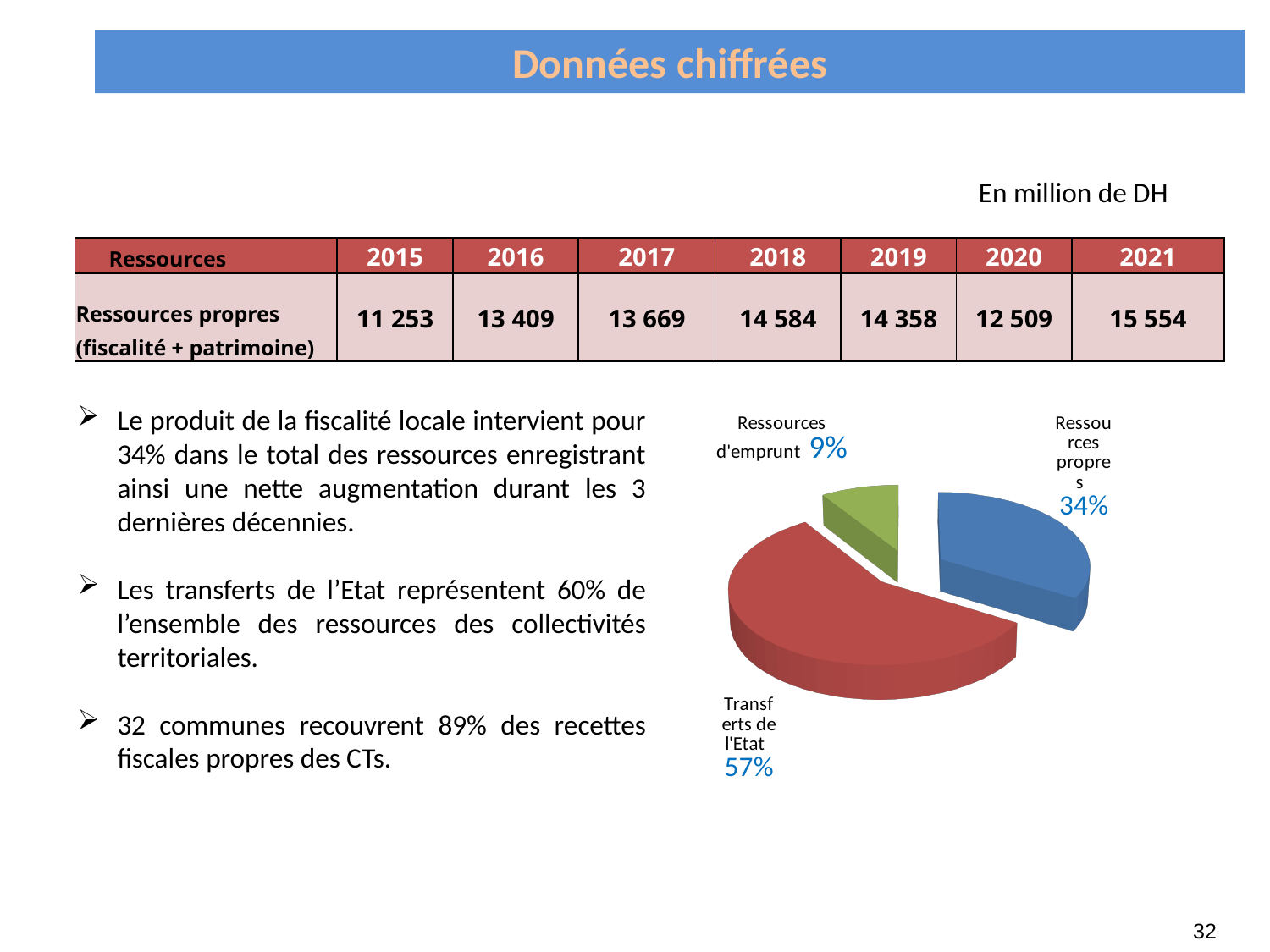
In the pie chart, which is larger: Ressources propres or Ressources d'emprunt? Ressources propres How many slices does the pie chart have? 3 In the pie chart, what is the difference in percentage points between Transferts de l'Etat and Ressources propres? 23 What share of the pie chart is Transferts de l'Etat? 57% What colour is the Transferts de l'Etat slice in the pie chart? red In the pie chart, what is the difference in percentage points between Ressources propres and Ressources d'emprunt? 25 Which slice of the pie chart is the largest? Transferts de l'Etat What colour is the Ressources d'emprunt slice in the pie chart? green What share of the pie chart is Ressources d'emprunt? 9% Which slice of the pie chart is the smallest? Ressources d'emprunt What kind of chart is shown on the slide? pie chart What share of the pie chart is Ressources propres? 34%